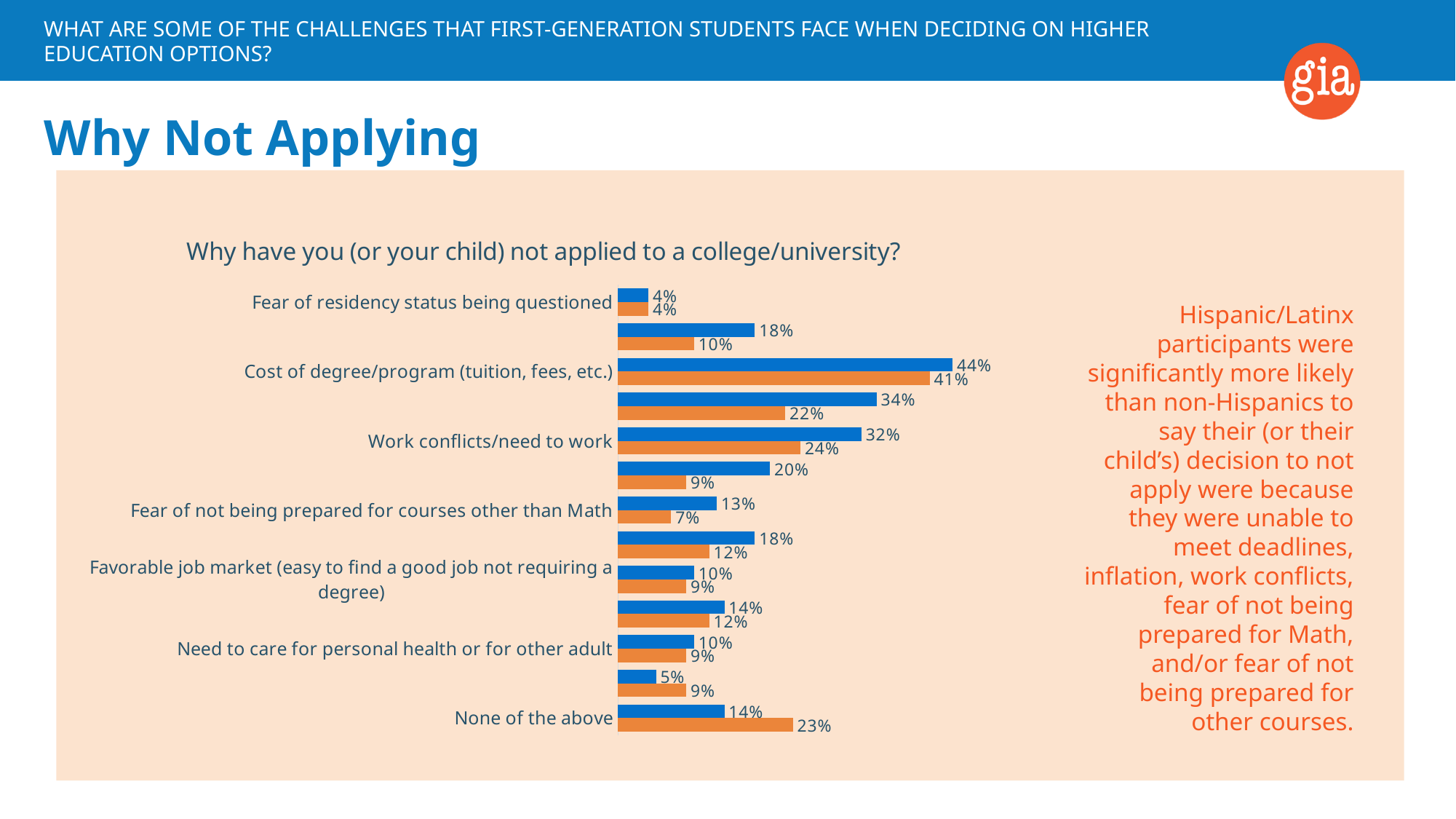
What survey question is shown as the chart's title? Why have you (or your child) not applied to a college/university? How many pairs of bars (rows) are plotted in the chart? 13 What is the value of the blue bar for "Cost of degree/program (tuition, fees, etc.)"? 44% Which labeled category has the highest blue bar value? Cost of degree/program (tuition, fees, etc.) What is the value of the blue bar for "Work conflicts/need to work"? 32% What kind of chart is shown on the slide? Bar chart What is the value of the blue bar for "Fear of residency status being questioned"? 4% For "None of the above", which bar is larger, the blue or the orange? Orange What is the difference between the blue and orange bar values for "Work conflicts/need to work"? 8 percentage points What is the value of the orange bar for "None of the above"? 23% What is the value of the orange bar for "Cost of degree/program (tuition, fees, etc.)"? 41% What is the difference between the blue and orange bar values for "Fear of not being prepared for courses other than Math"? 6 percentage points